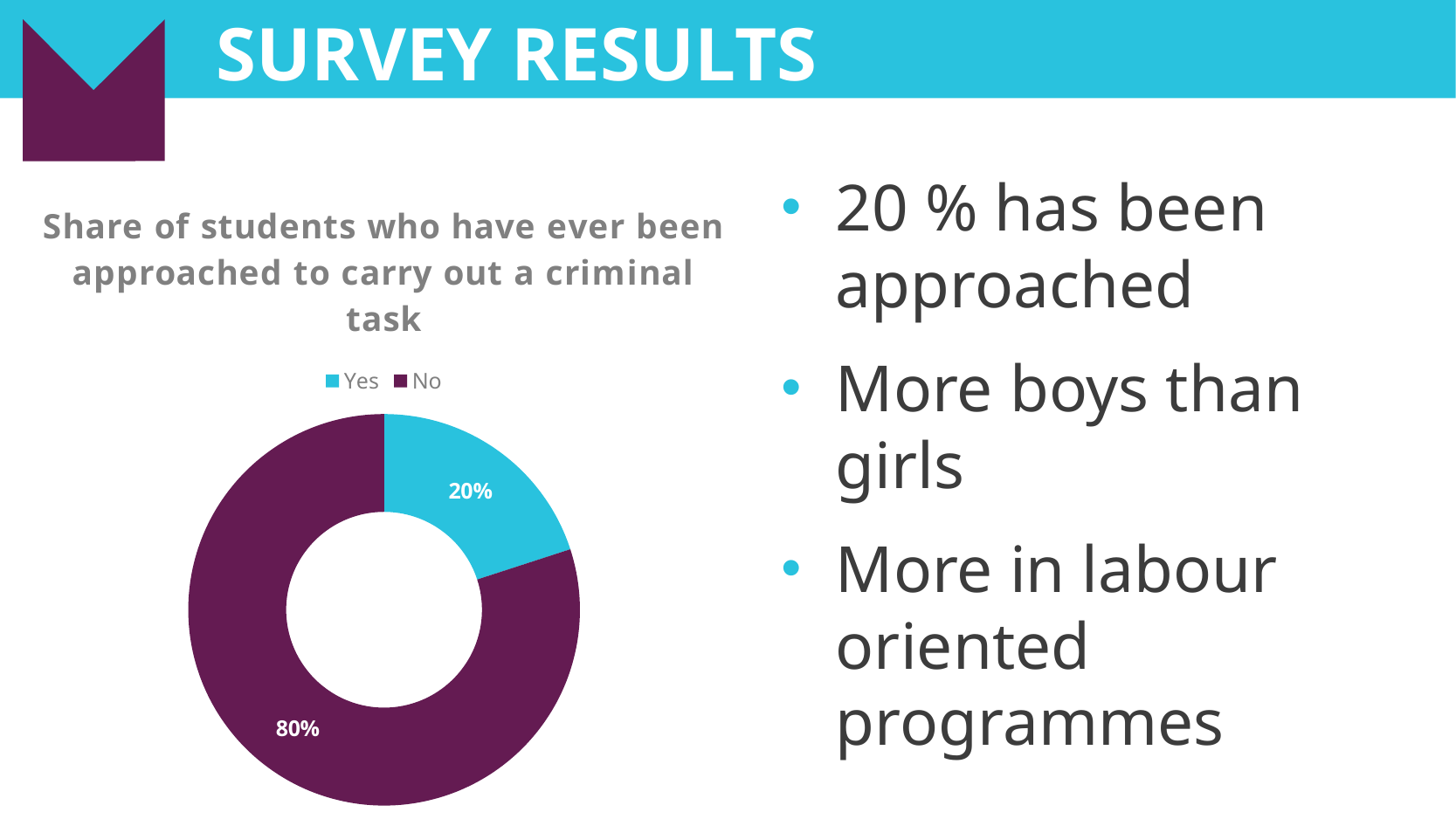
What is the title of the chart? Share of students who have ever been approached to carry out a criminal task What share of students answered No in the chart? 80% Which category has the largest share in the chart? No What kind of chart is shown on the slide? Pie chart (doughnut) What share of students answered Yes in the chart? 20% What is the difference in percentage points between the No and Yes shares? 60 Which is larger, the share for Yes or the share for No? No How many categories does the chart show? 2 Which category has the smallest share in the chart? Yes Is the share for No greater or less than 50%? greater How many entries does the chart legend list? 2 Which colour represents the Yes category in the chart? Light blue